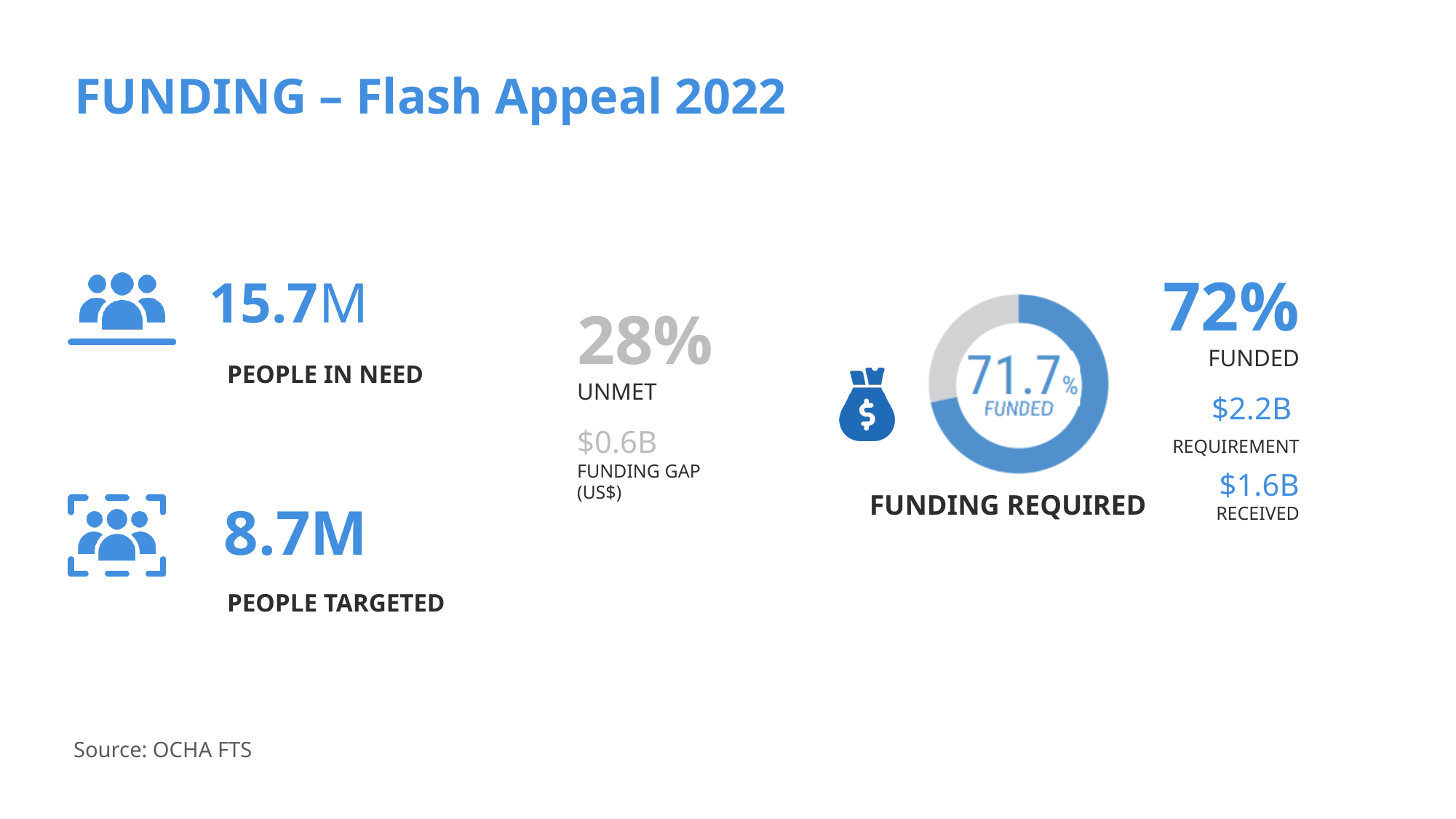
How many people are shown as in need? 15.7M What is the funding requirement shown next to the donut chart? $2.2B What kind of chart is shown in the centre of the slide under 'FUNDING REQUIRED'? pie chart (donut) What percentage is shown as funded in the centre of the donut chart? 71.7% What percentage of the funding requirement is shown as unmet? 28% What colour is the funded portion of the donut chart? blue How much funding is shown as received? $1.6B What is the difference between the number of people in need and the number of people targeted? 7.0M What is the difference between the funding requirement and the funding received? $0.6B Which is larger, the number of people in need or the number of people targeted? people in need What is the funding gap in US$ shown on the slide? $0.6B How many segments does the donut chart have? 2